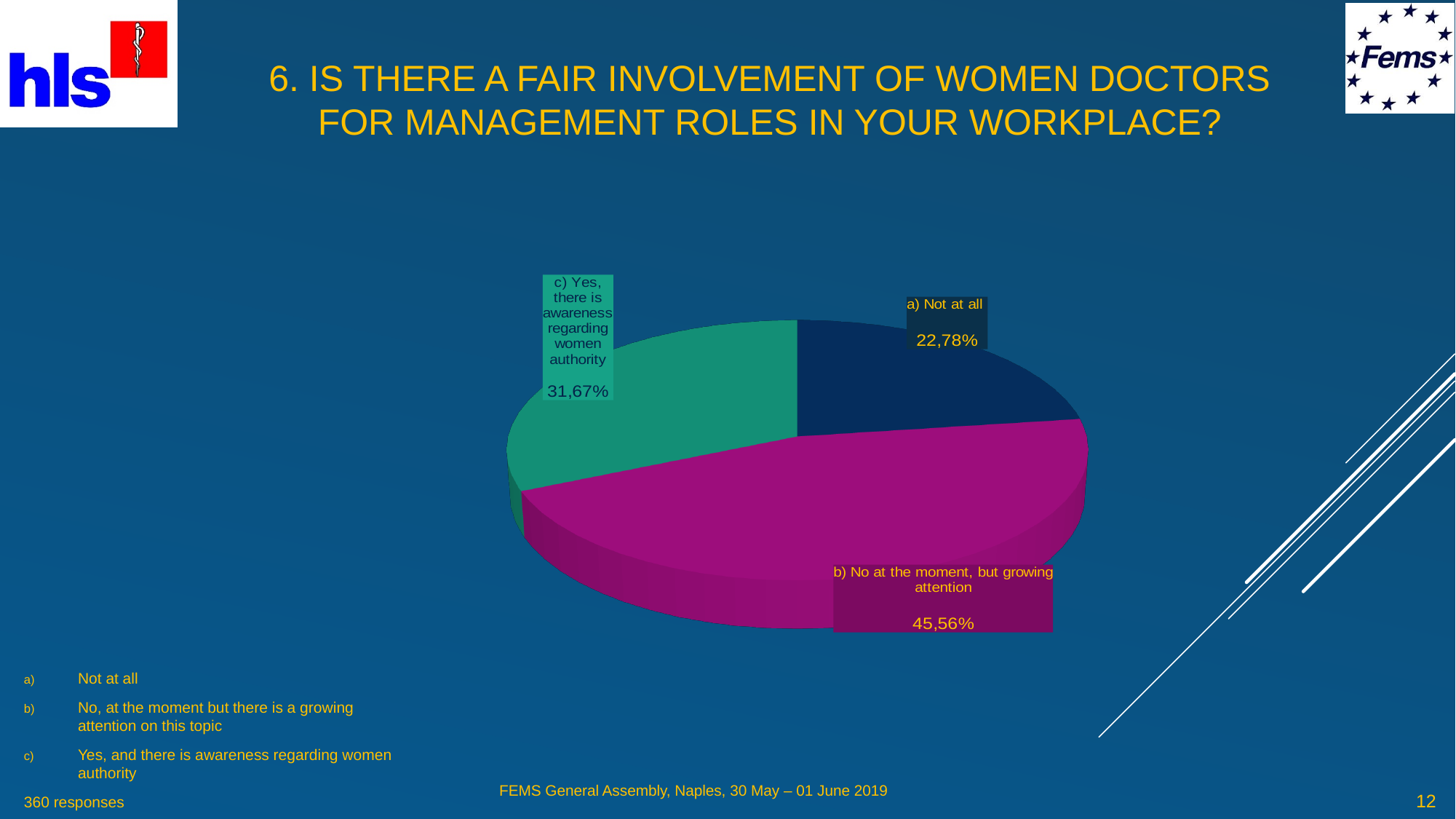
What is the difference in percentage points between the "c) Yes, there is awareness regarding women authority" slice and the "a) Not at all" slice? 8,89 What kind of chart is shown on the slide? pie chart What colour is the "b) No at the moment, but growing attention" slice? magenta How many slices does the pie chart have? 3 Which slice of the pie chart is the smallest? a) Not at all Which slice of the pie chart is the largest? b) No at the moment, but growing attention What is the difference in percentage points between the "b) No at the moment, but growing attention" slice and the "a) Not at all" slice? 22,78 What percentage of responses is shown for "c) Yes, there is awareness regarding women authority"? 31,67% What percentage of responses is shown for "a) Not at all"? 22,78% What percentage of responses is shown for "b) No at the moment, but growing attention"? 45,56% Which is larger: the "c) Yes, there is awareness regarding women authority" slice or the "a) Not at all" slice? c) Yes, there is awareness regarding women authority How many responses does the slide say the chart is based on? 360 responses